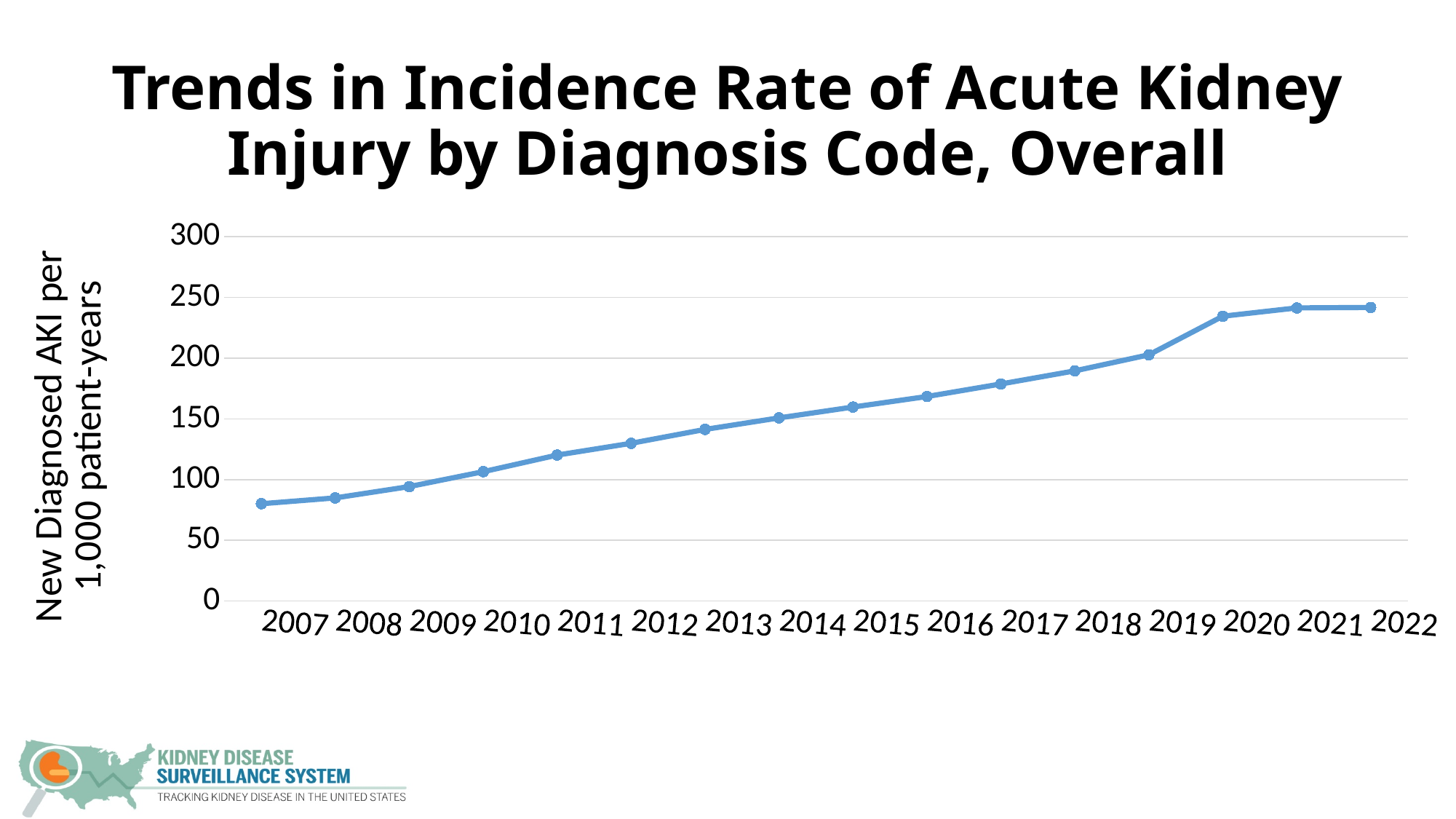
Is the value for 2007 greater or less than 100? less What is the label on the y axis of the chart? New Diagnosed AKI per 1,000 patient-years Do the values generally rise or fall from 2007 to 2022? rise Is the value for 2011 greater or less than 100? greater Is the value for 2018 greater or less than 200? less What kind of chart is shown on the slide? line chart Which year has the larger value, 2019 or 2009? 2019 Which year has the lowest incidence rate of acute kidney injury? 2007 Which year has the larger value, 2012 or 2017? 2017 How many years are plotted on the x axis of the chart? 16